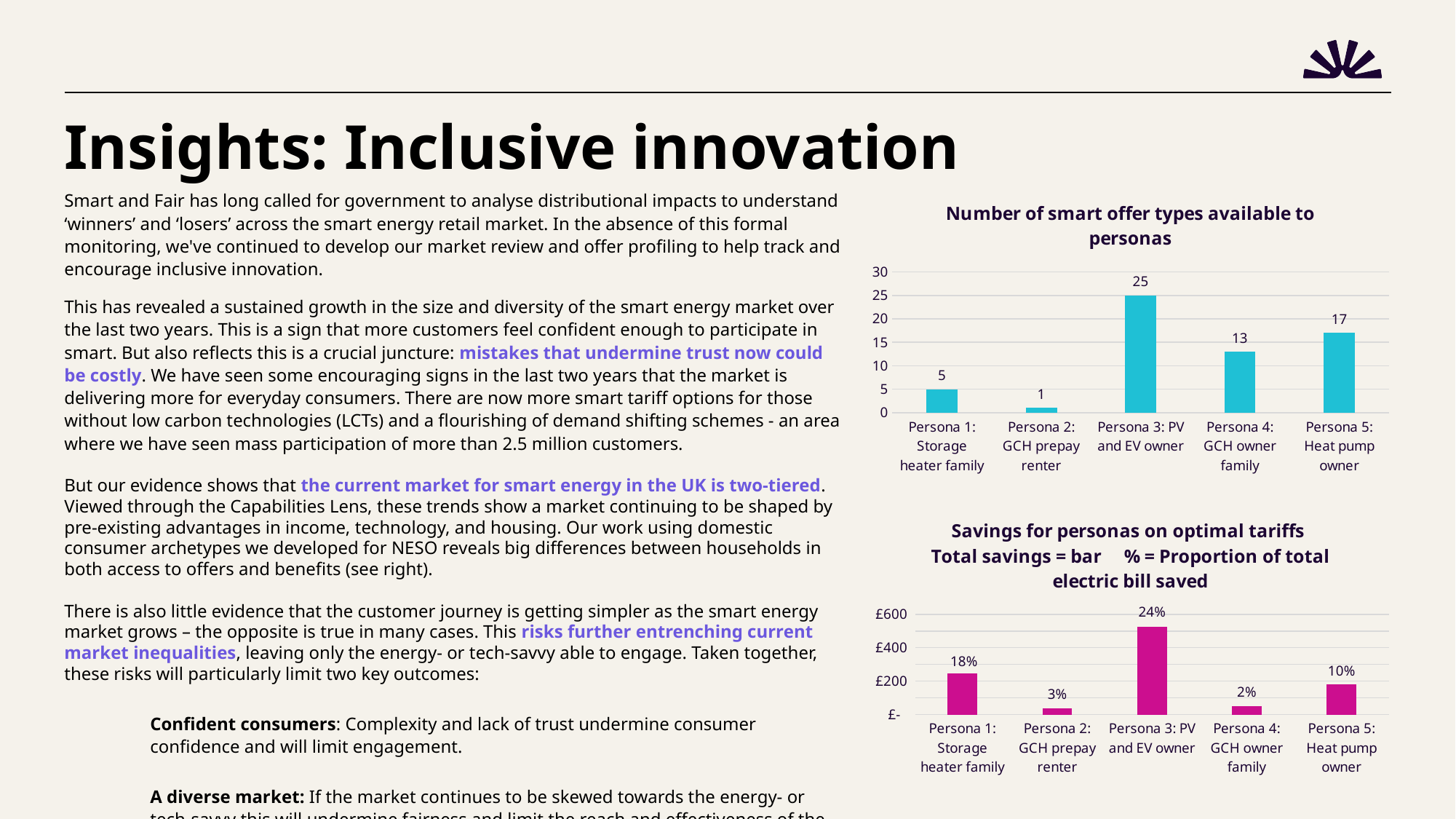
In the 'Savings for personas on optimal tariffs' chart, what proportion of the total electric bill is saved by Persona 4: GCH owner family? 2% In the 'Number of smart offer types available to personas' chart, how many smart offer types are available to Persona 2: GCH prepay renter? 1 In the 'Number of smart offer types available to personas' chart, what is the difference between the values for Persona 5: Heat pump owner and Persona 4: GCH owner family? 4 In the 'Number of smart offer types available to personas' chart, how many smart offer types are available to Persona 3: PV and EV owner? 25 In the 'Savings for personas on optimal tariffs' chart, is the total savings bar for Persona 2: GCH prepay renter greater or less than £200? less In the 'Savings for personas on optimal tariffs' chart, what proportion of the total electric bill is saved by Persona 3: PV and EV owner? 24% What type of chart is the 'Savings for personas on optimal tariffs' chart? Bar chart In the 'Number of smart offer types available to personas' chart, which has more smart offer types: Persona 1: Storage heater family or Persona 4: GCH owner family? Persona 4: GCH owner family How many personas are shown in the 'Number of smart offer types available to personas' chart? 5 In the 'Number of smart offer types available to personas' chart, which persona has the highest number of smart offer types? Persona 3: PV and EV owner In the 'Savings for personas on optimal tariffs' chart, is the total savings bar for Persona 3: PV and EV owner greater or less than £400? greater In the 'Number of smart offer types available to personas' chart, which persona has the lowest number of smart offer types? Persona 2: GCH prepay renter